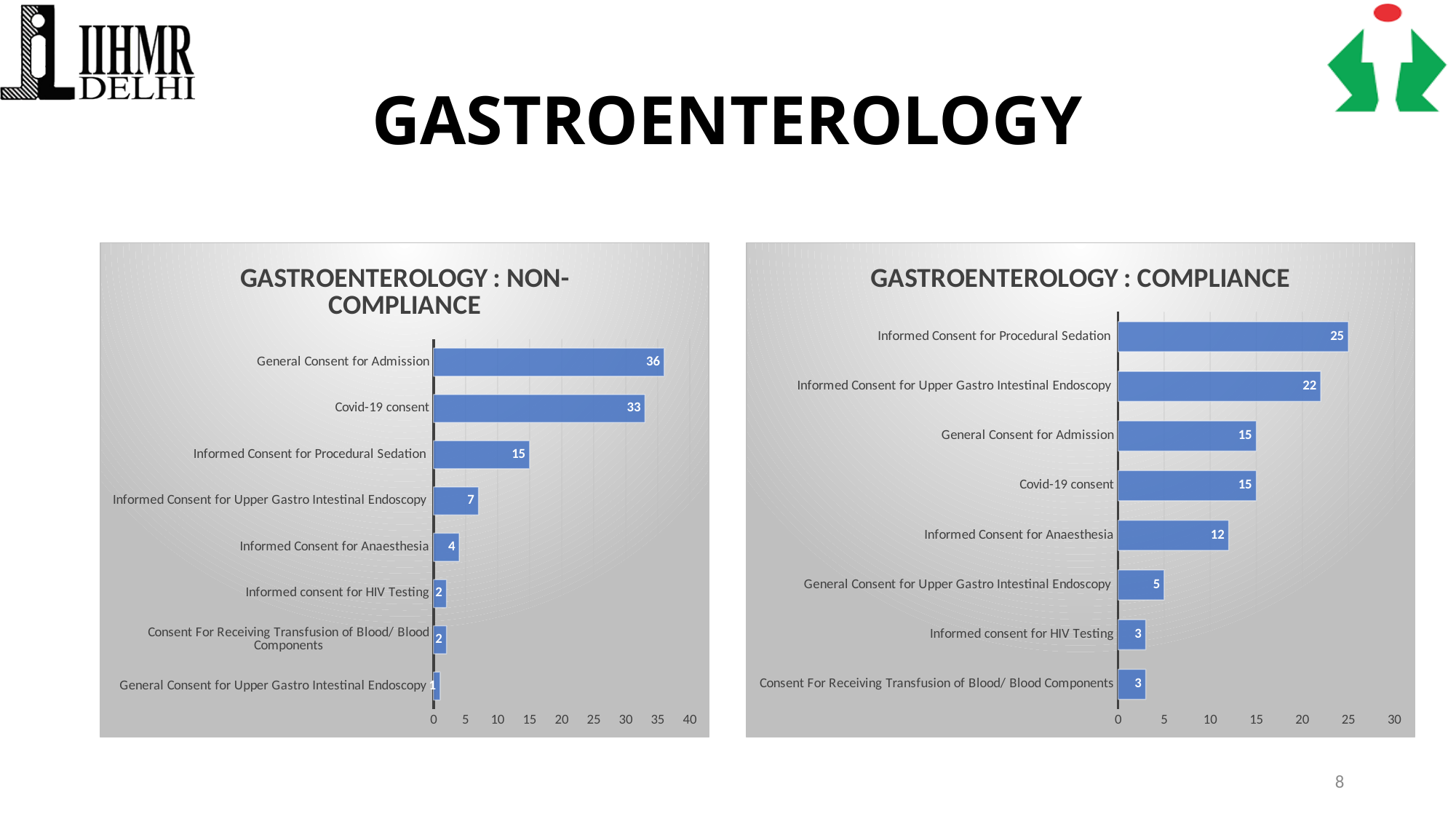
How many categories are shown in the GASTROENTEROLOGY : COMPLIANCE chart? 8 In the GASTROENTEROLOGY : NON-COMPLIANCE chart, which category has the lowest value? General Consent for Upper Gastro Intestinal Endoscopy In the GASTROENTEROLOGY : COMPLIANCE chart, is the value for Informed Consent for Upper Gastro Intestinal Endoscopy greater or less than 20? greater In the GASTROENTEROLOGY : COMPLIANCE chart, what is the value for Informed Consent for Anaesthesia? 12 What kind of chart is the GASTROENTEROLOGY : NON-COMPLIANCE chart? Bar chart In the GASTROENTEROLOGY : COMPLIANCE chart, which category has the highest value? Informed Consent for Procedural Sedation In the GASTROENTEROLOGY : NON-COMPLIANCE chart, what is the value for General Consent for Admission? 36 In the GASTROENTEROLOGY : COMPLIANCE chart, what is the value for Informed consent for HIV Testing? 3 In the GASTROENTEROLOGY : COMPLIANCE chart, what is the difference between the values for Informed Consent for Procedural Sedation and Informed Consent for Upper Gastro Intestinal Endoscopy? 3 In the GASTROENTEROLOGY : NON-COMPLIANCE chart, which is larger: Informed Consent for Procedural Sedation or Informed Consent for Upper Gastro Intestinal Endoscopy? Informed Consent for Procedural Sedation In the GASTROENTEROLOGY : NON-COMPLIANCE chart, what is the difference between the values for General Consent for Admission and Covid-19 consent? 3 What is the title of the chart on the left side of the slide? GASTROENTEROLOGY : NON-COMPLIANCE